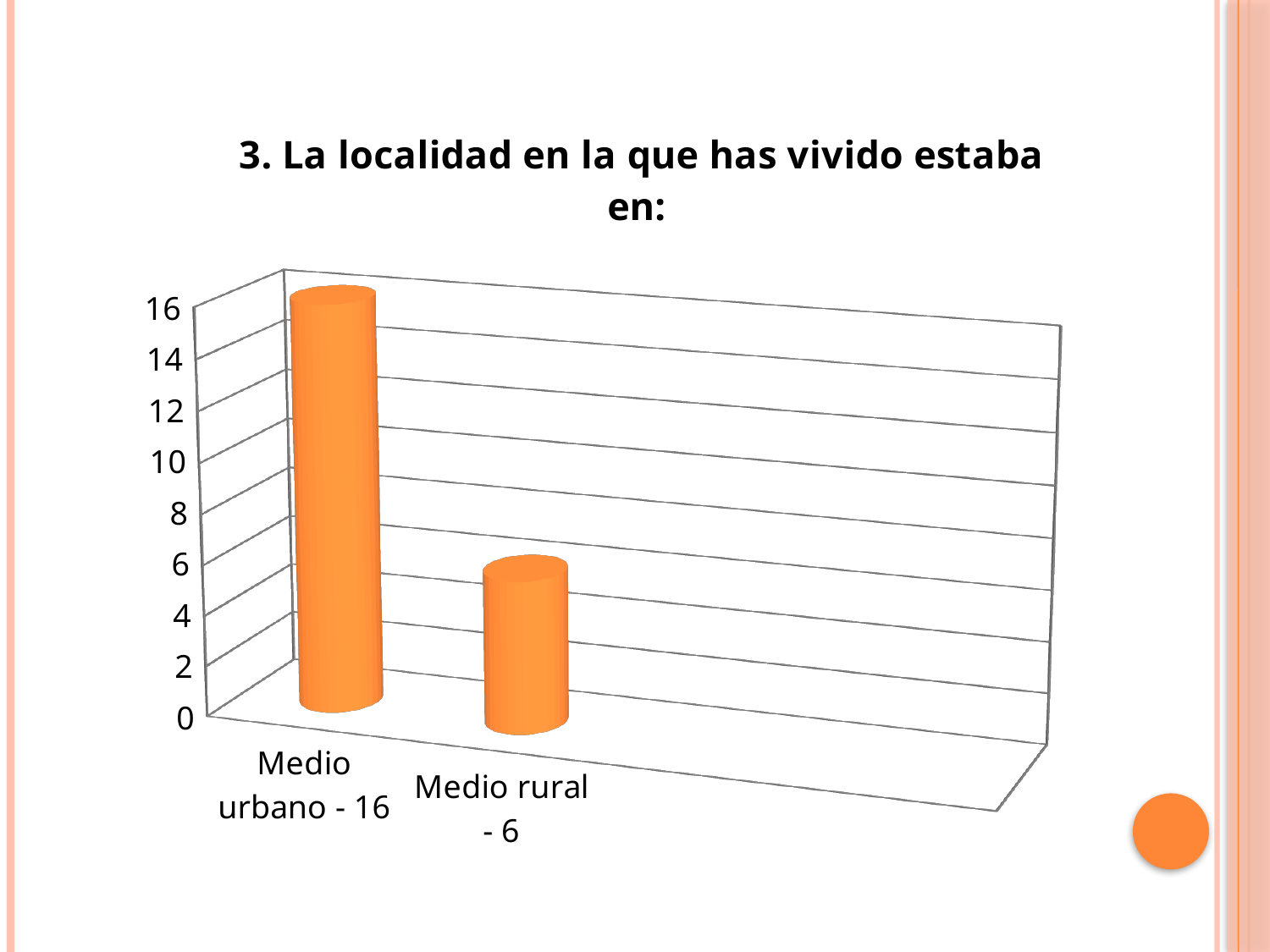
Is the value for Medio rural greater or less than 10? less What is the value for Medio urbano? 16 Is the value for Medio urbano greater or less than 12? greater Which is larger, the value for Medio urbano or the value for Medio rural? Medio urbano What kind of chart is shown on the slide? bar chart What is the title of the chart? 3. La localidad en la que has vivido estaba en: What is the highest value shown on the vertical axis? 16 How many categories are shown in the chart? 2 Which category has the lowest value? Medio rural Which category has the highest value? Medio urbano What is the value for Medio rural? 6 What is the difference between the values for Medio urbano and Medio rural? 10